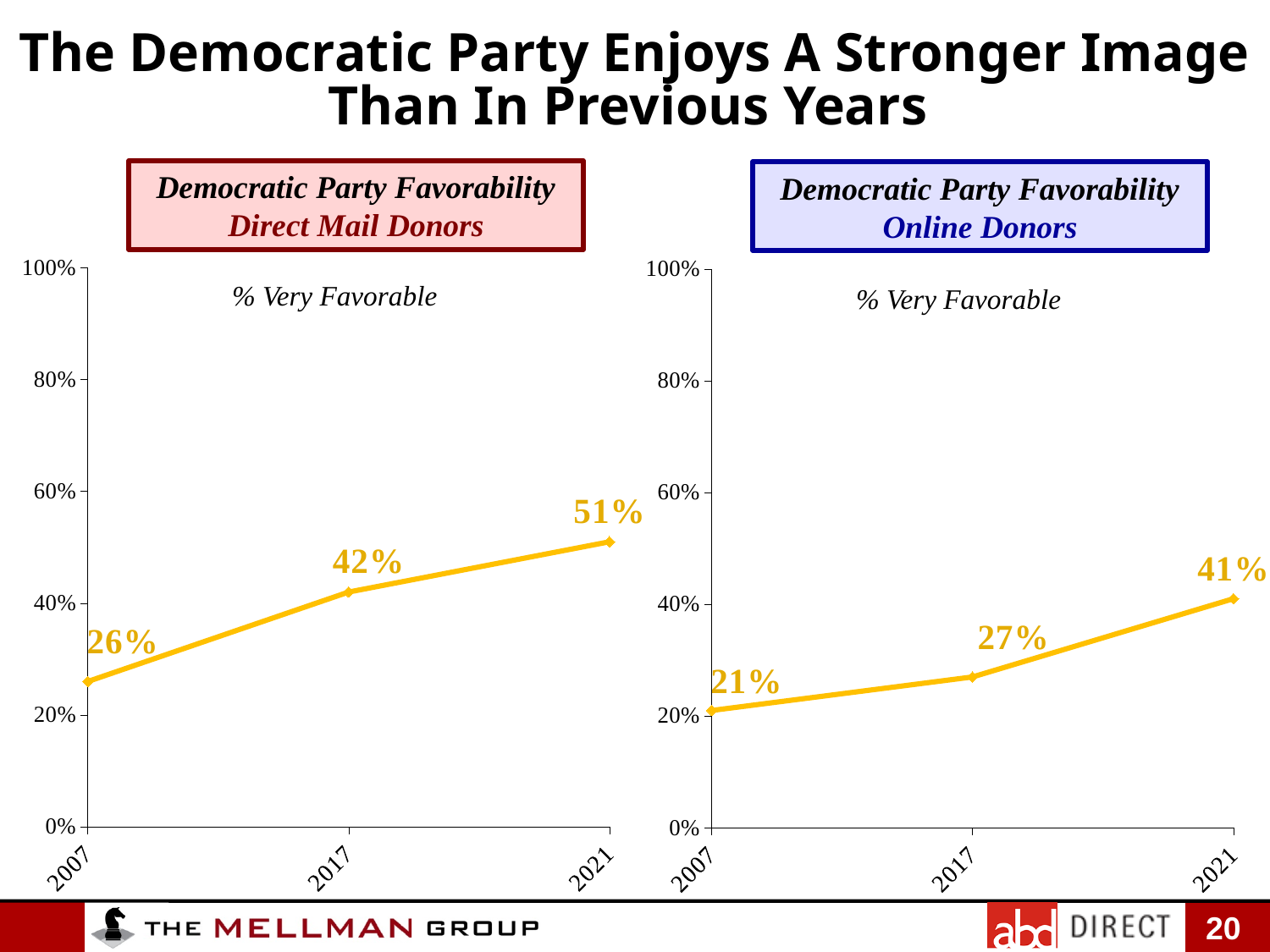
In the Direct Mail Donors chart, which year has the highest % Very Favorable value? 2021 In the Online Donors chart, which year has the lowest % Very Favorable value? 2007 In the Direct Mail Donors chart, what is the difference between the 2021 and 2007 values? 25 percentage points In the Online Donors chart, what is the % Very Favorable value for 2017? 27% How many data points are plotted in the Online Donors chart? 3 In the Direct Mail Donors chart, do the values rise or fall from 2007 to 2021? Rise In the Direct Mail Donors chart, what is the % Very Favorable value for 2007? 26% What type of chart is used for the Direct Mail Donors data? Line chart In the Direct Mail Donors chart, what is the % Very Favorable value for 2021? 51% In the Online Donors chart, what is the % Very Favorable value for 2021? 41% In the Online Donors chart, what is the difference between the 2021 and 2017 values? 14 percentage points Which is larger: the 2017 value in the Direct Mail Donors chart or the 2017 value in the Online Donors chart? Direct Mail Donors (42%)